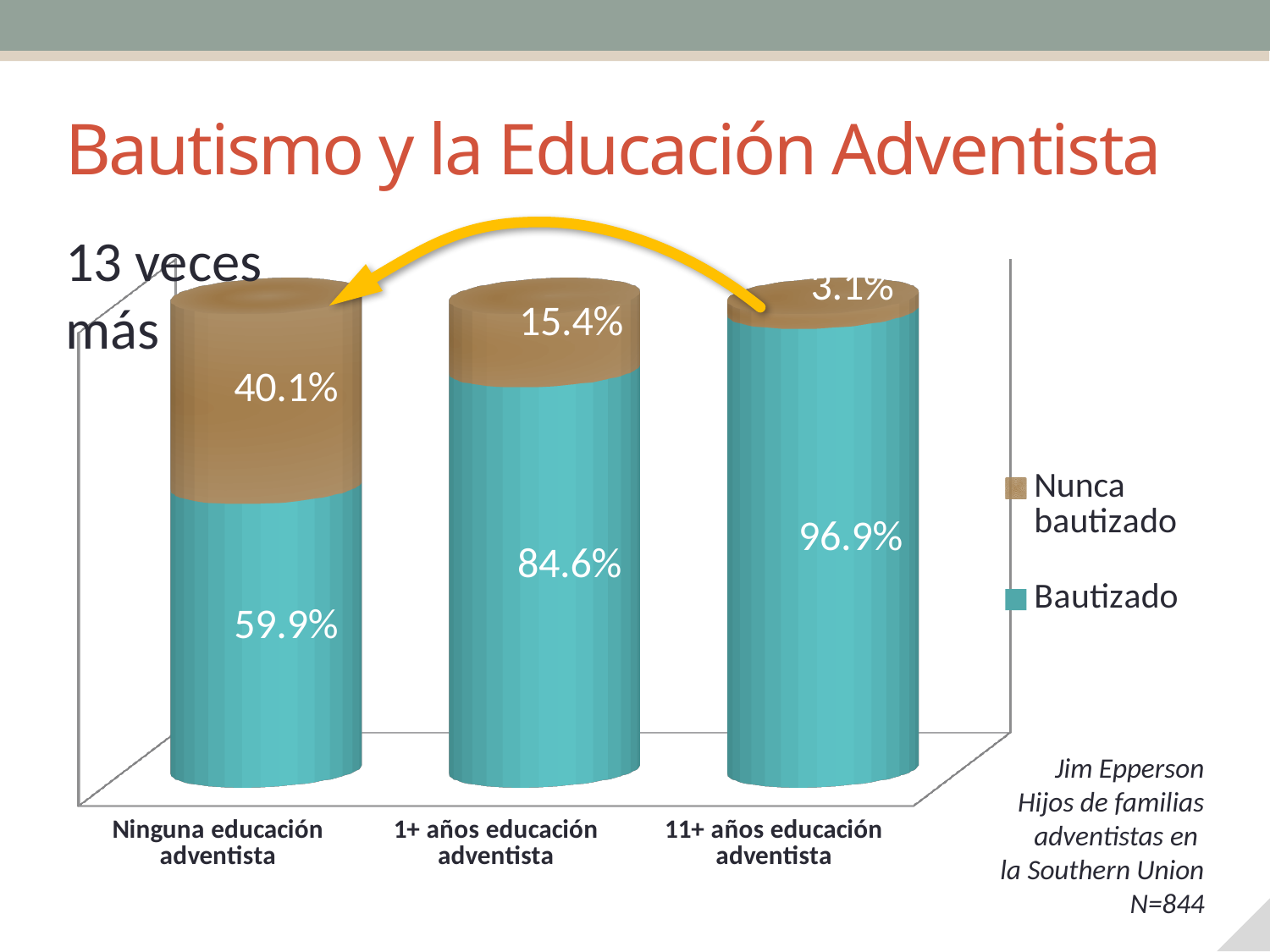
What kind of chart is shown on the slide? Stacked bar chart Which category has the highest Bautizado value? 11+ años educación adventista What is the Bautizado value for 'Ninguna educación adventista'? 59.9% Which is larger: the Nunca bautizado value for 'Ninguna educación adventista' or for '1+ años educación adventista'? Ninguna educación adventista How many series does the legend list? 2 What is the Nunca bautizado value for '1+ años educación adventista'? 15.4% What is the Bautizado value for '11+ años educación adventista'? 96.9% How many categories are shown on the x axis? 3 Does the Bautizado value rise or fall from left to right across the categories? Rise Which category has the lowest Nunca bautizado value? 11+ años educación adventista What is the difference between the Bautizado values for '11+ años educación adventista' and 'Ninguna educación adventista'? 37.0% What is the Nunca bautizado value for '11+ años educación adventista'? 3.1%